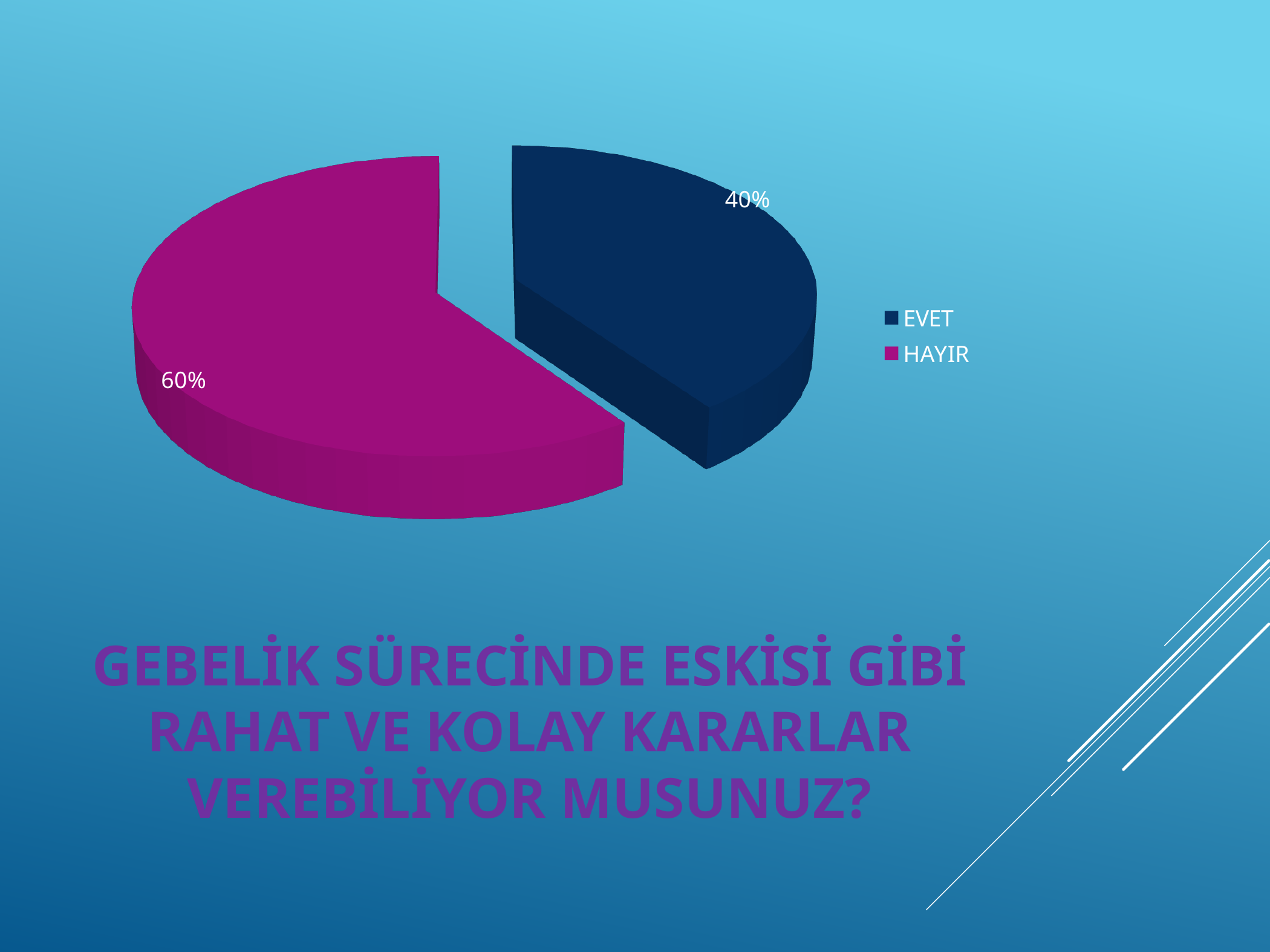
Which category has the largest share of the pie chart? HAYIR What percentage of the pie chart is labelled EVET? 40% What is the difference in percentage points between the HAYIR and EVET slices? 20 percentage points What question is written below the pie chart? GEBELİK SÜRECİNDE ESKİSİ GİBİ RAHAT VE KOLAY KARARLAR VEREBİLİYOR MUSUNUZ? How many entries does the legend list? 2 What percentage of the pie chart is labelled HAYIR? 60% What share of the pie does the EVET slice represent? 40% What kind of chart is shown on the slide? Pie chart What colour is the HAYIR slice in the pie chart? Magenta Which category has the smallest share of the pie chart? EVET Which slice is larger, EVET or HAYIR? HAYIR How many slices does the pie chart have? 2